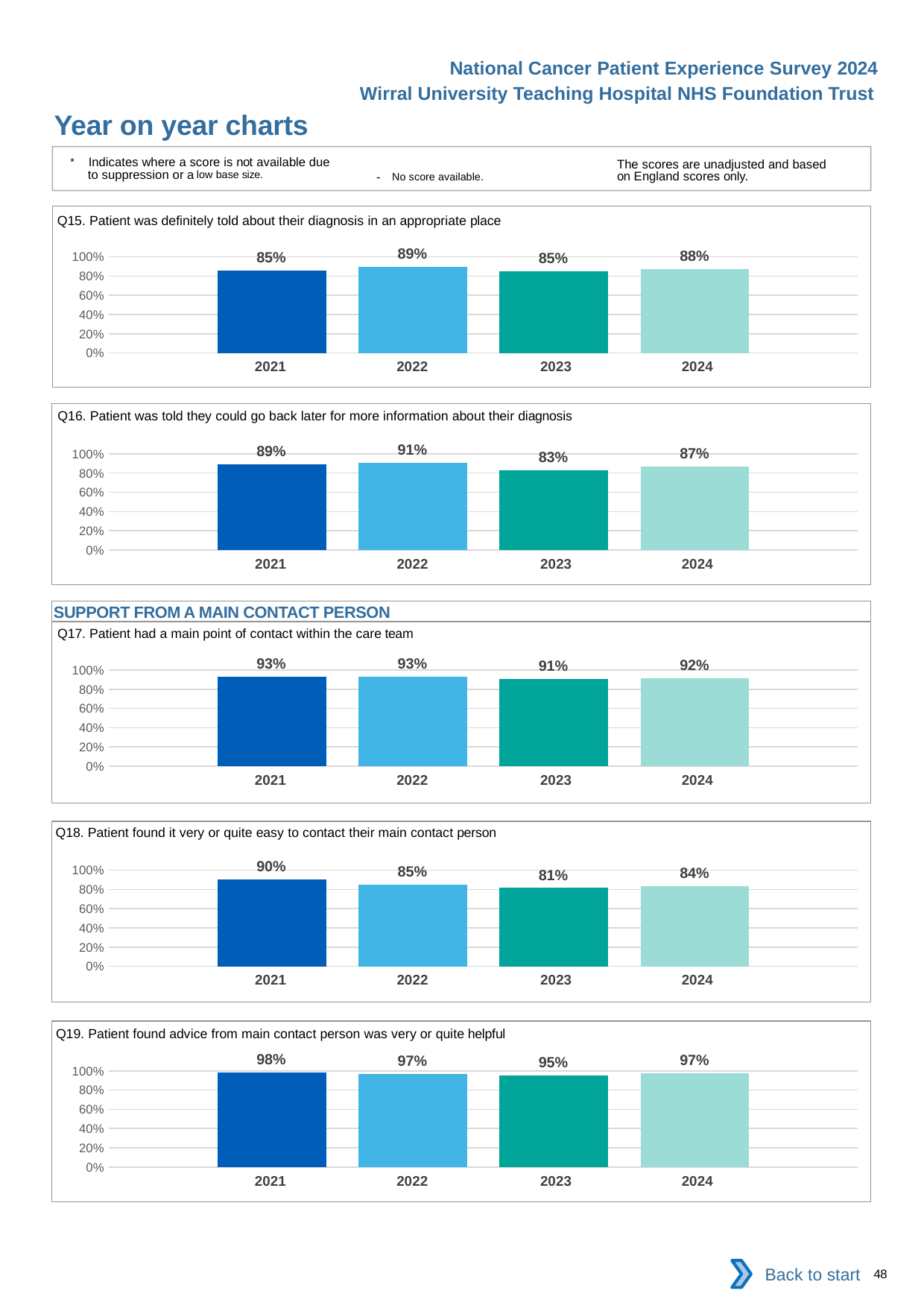
In the Q18 chart (patient found it very or quite easy to contact their main contact person), what is the value for 2021? 90% In the Q17 chart, which year has the lowest value? 2023 What type of chart is used for Q15? Bar chart How many years are shown on the x axis of the Q19 chart? 4 In the Q19 chart (patient found advice from main contact person was very or quite helpful), what is the value for 2023? 95% In the Q15 chart, which year has the lowest value? 2021 and 2023 (both 85%) In the Q15 chart (patient was definitely told about their diagnosis in an appropriate place), what is the value for 2022? 89% In the Q16 chart, what is the difference between the 2022 and 2023 values? 8 percentage points In the Q17 chart (patient had a main point of contact within the care team), what is the value for 2024? 92% In the Q18 chart, is the value for 2021 larger or smaller than the value for 2024? larger In the Q16 chart, which year has the highest value? 2022 In the Q16 chart (patient was told they could go back later for more information about their diagnosis), what is the value for 2023? 83%